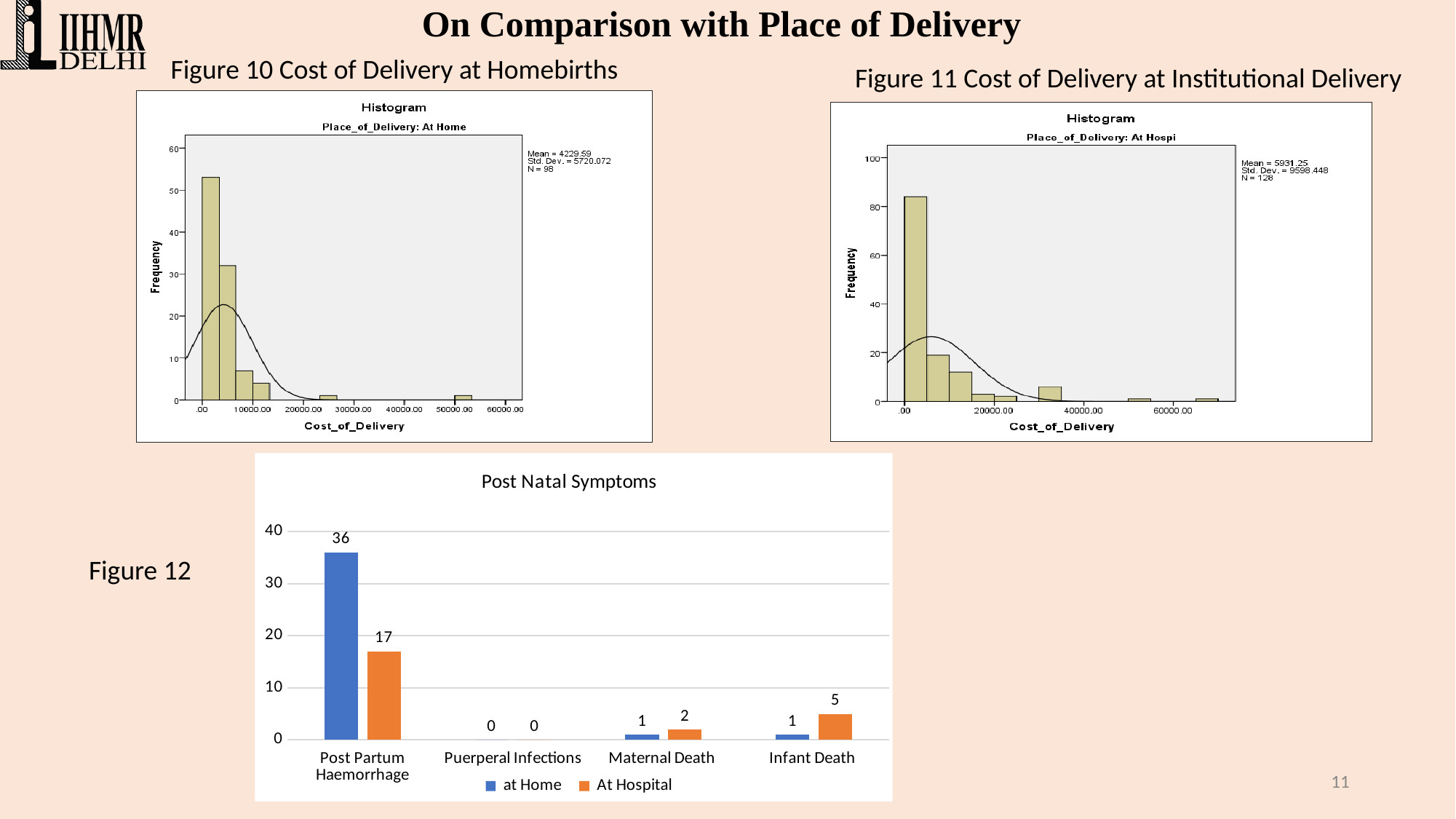
In the Post Natal Symptoms chart (Figure 12), which is larger for Infant Death: at Home or At Hospital? At Hospital In the Post Natal Symptoms chart (Figure 12), what is the value for Maternal Death At Hospital? 2 In the Post Natal Symptoms chart (Figure 12), what is the value for Infant Death At Hospital? 5 In the Post Natal Symptoms chart (Figure 12), what is the difference between the at Home and At Hospital values for Post Partum Haemorrhage? 19 What kind of chart is Figure 12 (Post Natal Symptoms)? bar chart What is the N value printed on the histogram in Figure 11 (Cost of Delivery at Institutional Delivery)? N = 128 In the Post Natal Symptoms chart (Figure 12), what is the value for Post Partum Haemorrhage at Home? 36 In the Post Natal Symptoms chart (Figure 12), which category has the highest value for the at Home series? Post Partum Haemorrhage How many series does the legend of the Post Natal Symptoms chart (Figure 12) list? 2 In Figure 11 (Cost of Delivery at Institutional Delivery), is the frequency of the tallest bar greater or less than 60? greater How many categories are shown on the x axis of the Post Natal Symptoms chart (Figure 12)? 4 In Figure 10 (Cost of Delivery at Homebirths), is the frequency of the tallest bar greater or less than 50? greater